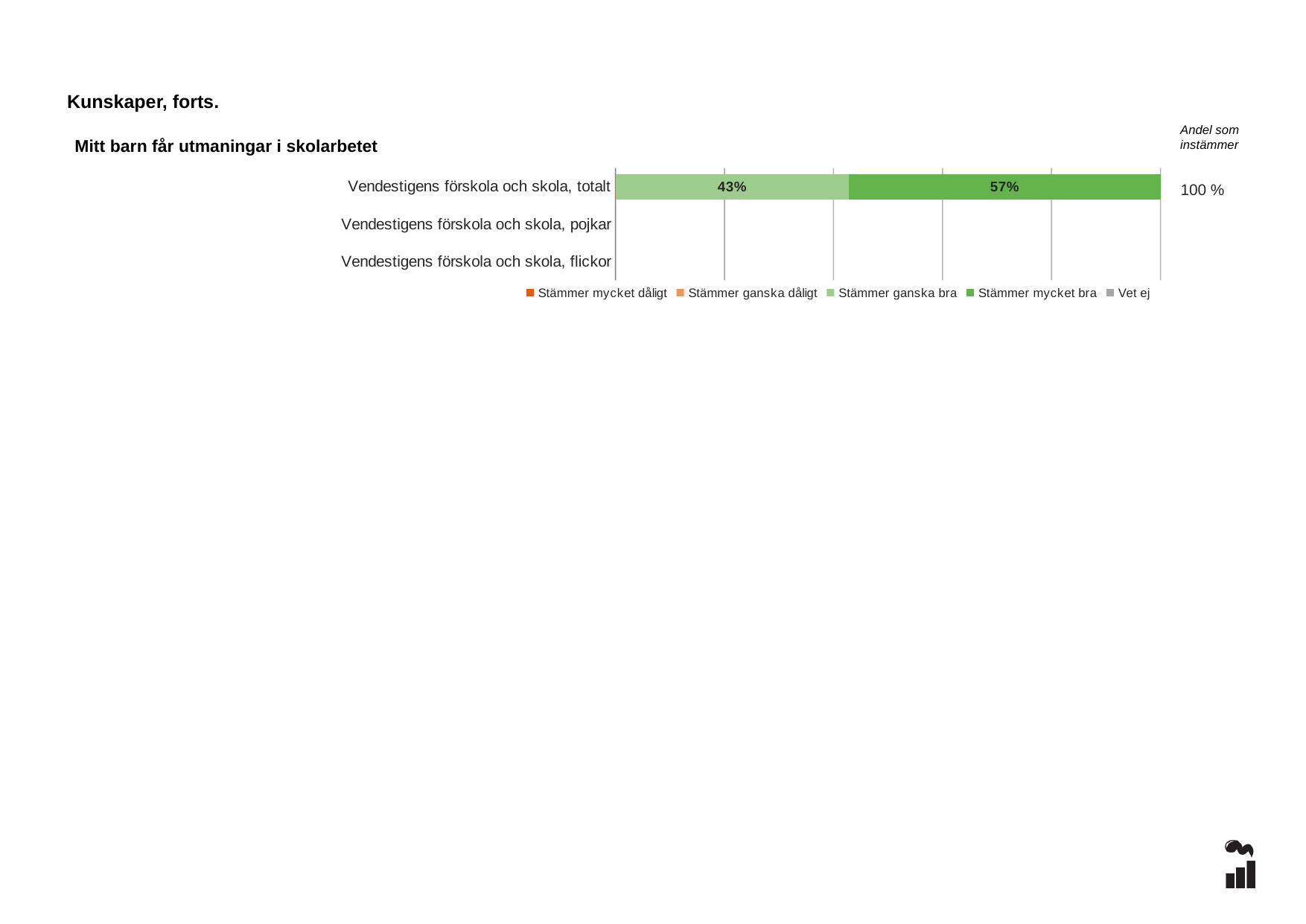
How many categories are shown on the y axis of the chart? 3 What is the title of the chart? Mitt barn får utmaningar i skolarbetet Is the value for 'Stämmer mycket bra' for 'Vendestigens förskola och skola, totalt' greater or less than 50%? greater How many series does the legend list? 5 What is the difference between 'Stämmer mycket bra' and 'Stämmer ganska bra' for 'Vendestigens förskola och skola, totalt'? 14% What is the value for 'Stämmer ganska bra' for 'Vendestigens förskola och skola, totalt'? 43% What 'Andel som instämmer' value is shown for 'Vendestigens förskola och skola, totalt'? 100 % What is the value for 'Stämmer mycket bra' for 'Vendestigens förskola och skola, totalt'? 57% Which legend entry is shown in the darkest green colour? Stämmer mycket bra What kind of chart is shown on the slide? bar chart For 'Vendestigens förskola och skola, totalt', which is larger: 'Stämmer ganska bra' or 'Stämmer mycket bra'? Stämmer mycket bra What is the total of the stacked bar for 'Vendestigens förskola och skola, totalt'? 100%